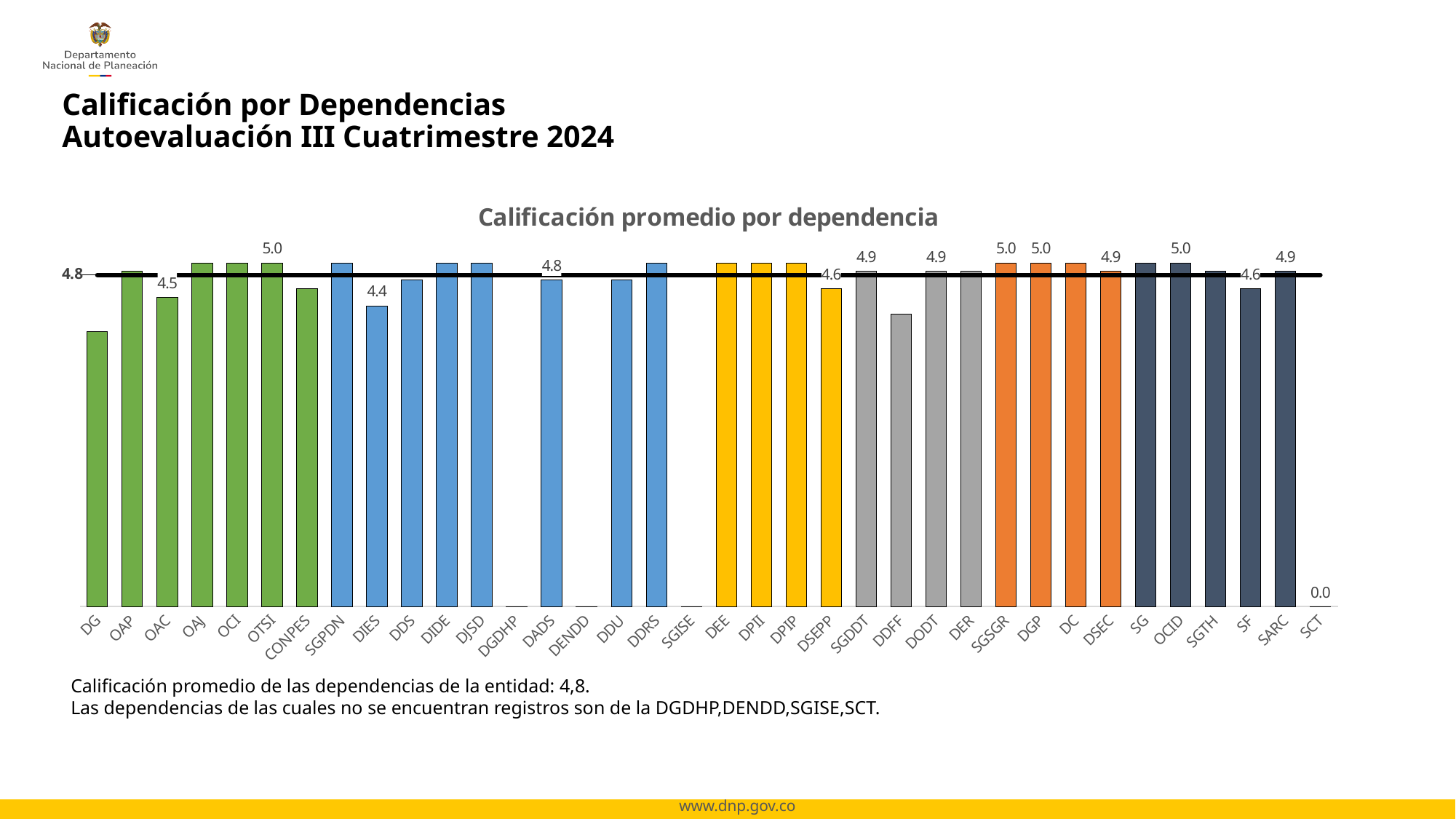
What is the difference between the values for DSEC and SF? 0.3 What value does the horizontal reference line across the chart mark? 4.8 What is the difference between the values for OTSI and DIES? 0.6 What is the value for OAC? 4.5 What is the value for OTSI? 5.0 What is the value for DIES? 4.4 What is the title of the chart? Calificación promedio por dependencia What kind of chart is shown on the slide? bar chart What is the value for SCT? 0.0 How many dependencies are listed on the x axis? 36 Which has a larger value, DGP or DSEPP? DGP What is the value for SF? 4.6